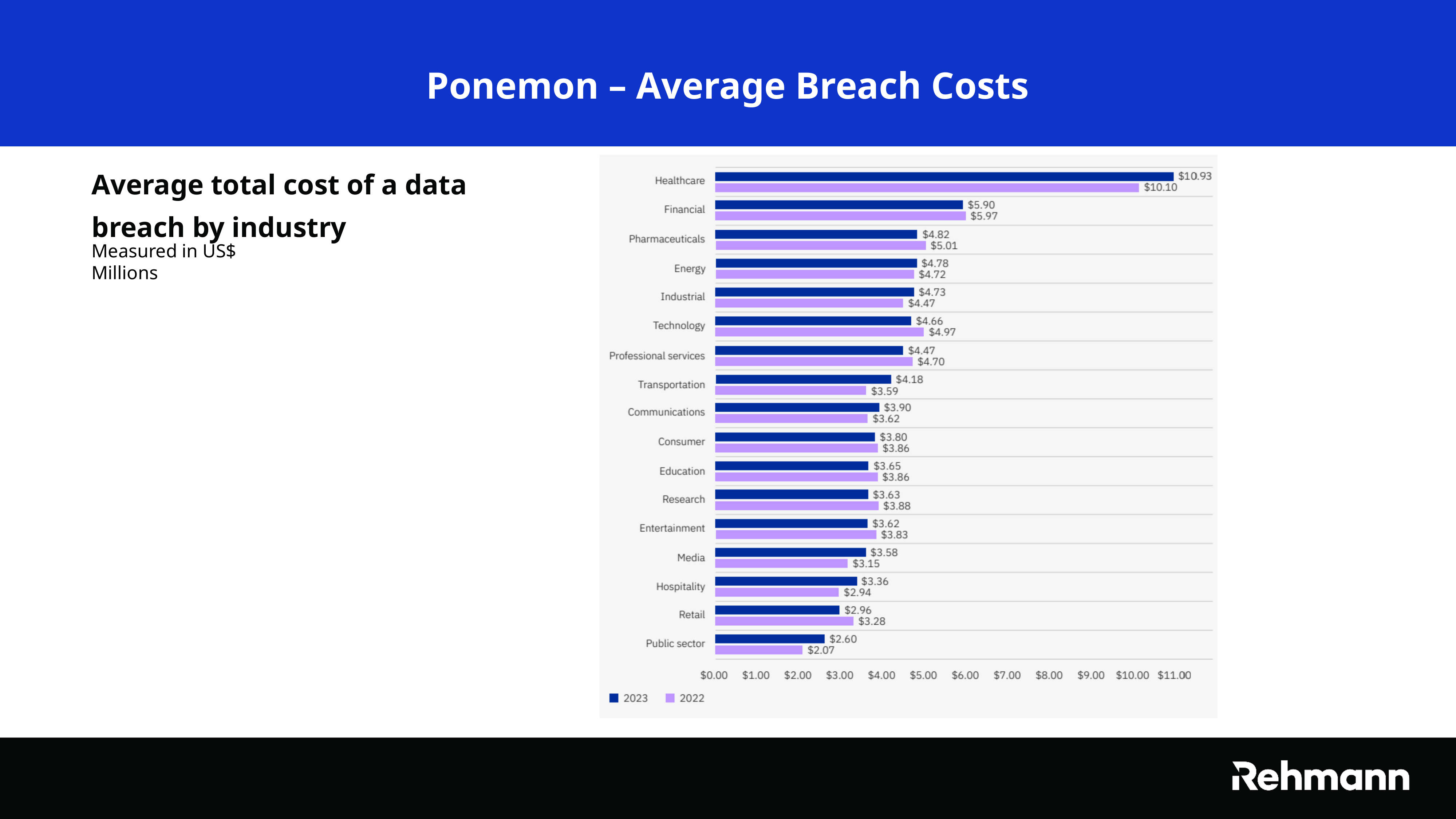
What is the 2023 average breach cost for Healthcare? $10.93 What is the 2022 average breach cost for Public sector? $2.07 What is the difference between the 2023 and 2022 values for Transportation? $0.59 Which industry has the highest 2023 average breach cost? Healthcare How many industries are shown on the chart? 17 What is the 2022 value for Technology? $4.97 What is the difference between the 2023 and 2022 values for Healthcare? $0.83 Which is larger for Financial: the 2023 value or the 2022 value? 2022 How many series does the legend list? 2 Is the 2023 value for Pharmaceuticals greater or less than $4.00? greater What kind of chart is shown on the slide? Bar chart Which industry has the lowest 2022 average breach cost? Public sector